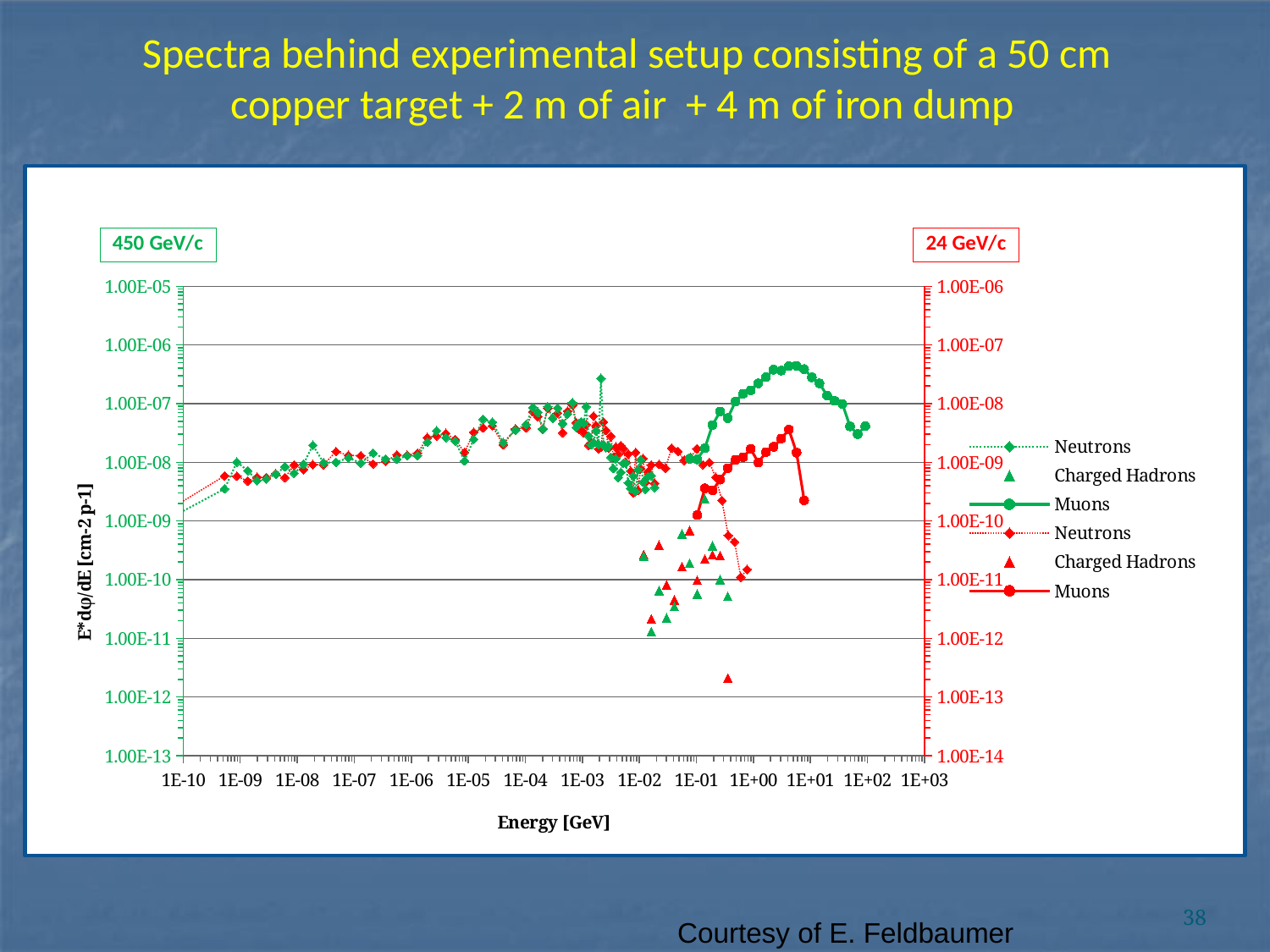
Does the green Muons series rise or fall between 1E-01 GeV and 1E+01 GeV? rise Does the green Muons series rise or fall between 1E+01 GeV and 1E+02 GeV? fall Is the peak value of the green Muons series greater or less than 1.00E-07 on the left axis? greater What beam momentum is associated with the left (green) y axis? 450 GeV/c What is the highest tick value shown on the right (red) y axis? 1.00E-06 Is the lowest green Charged Hadrons point greater or less than 1.00E-10 on the left axis? less What is the lowest tick value shown on the left (green) y axis? 1.00E-13 Which series reaches the highest value on the chart: green Muons or green Neutrons? green Muons How many series does the legend list? 6 What kind of chart is shown on the slide? Scatter (line) chart with log axes What is the label of the x axis? Energy [GeV] What is the lowest energy tick shown on the x axis? 1E-10